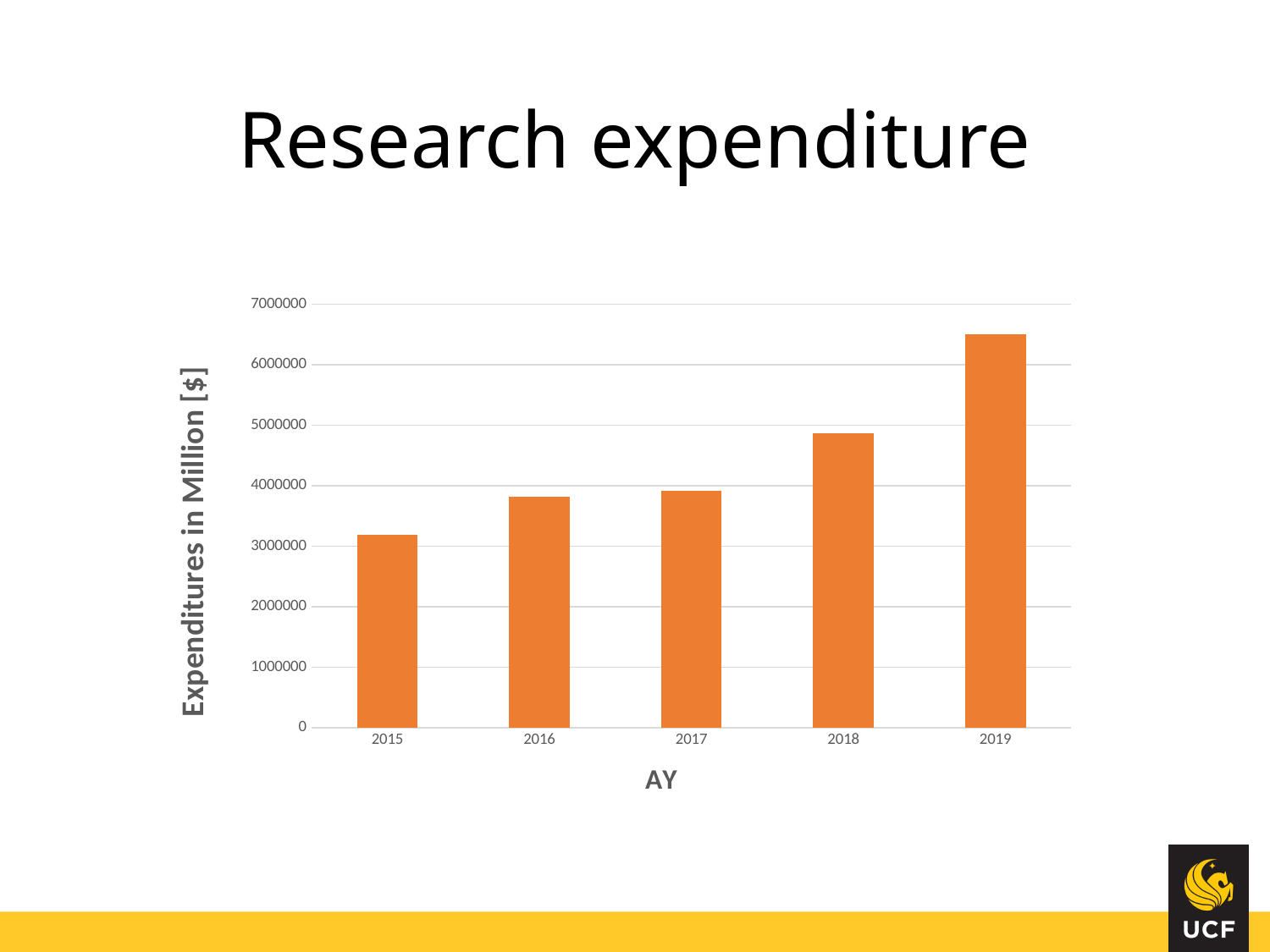
Is the value for 2015 greater or less than 3000000? greater Is the value for 2019 greater or less than 6000000? greater Do the expenditures rise or fall from 2015 to 2019? rise Is the value for 2016 greater or less than 4000000? less Which year has the lowest research expenditure? 2015 What is the title of the slide? Research expenditure Which year has the larger expenditure, 2015 or 2018? 2018 Which year has the highest research expenditure? 2019 How many years (bars) are shown on the x axis? 5 What kind of chart is shown on the slide? bar chart What is the label of the x axis? AY